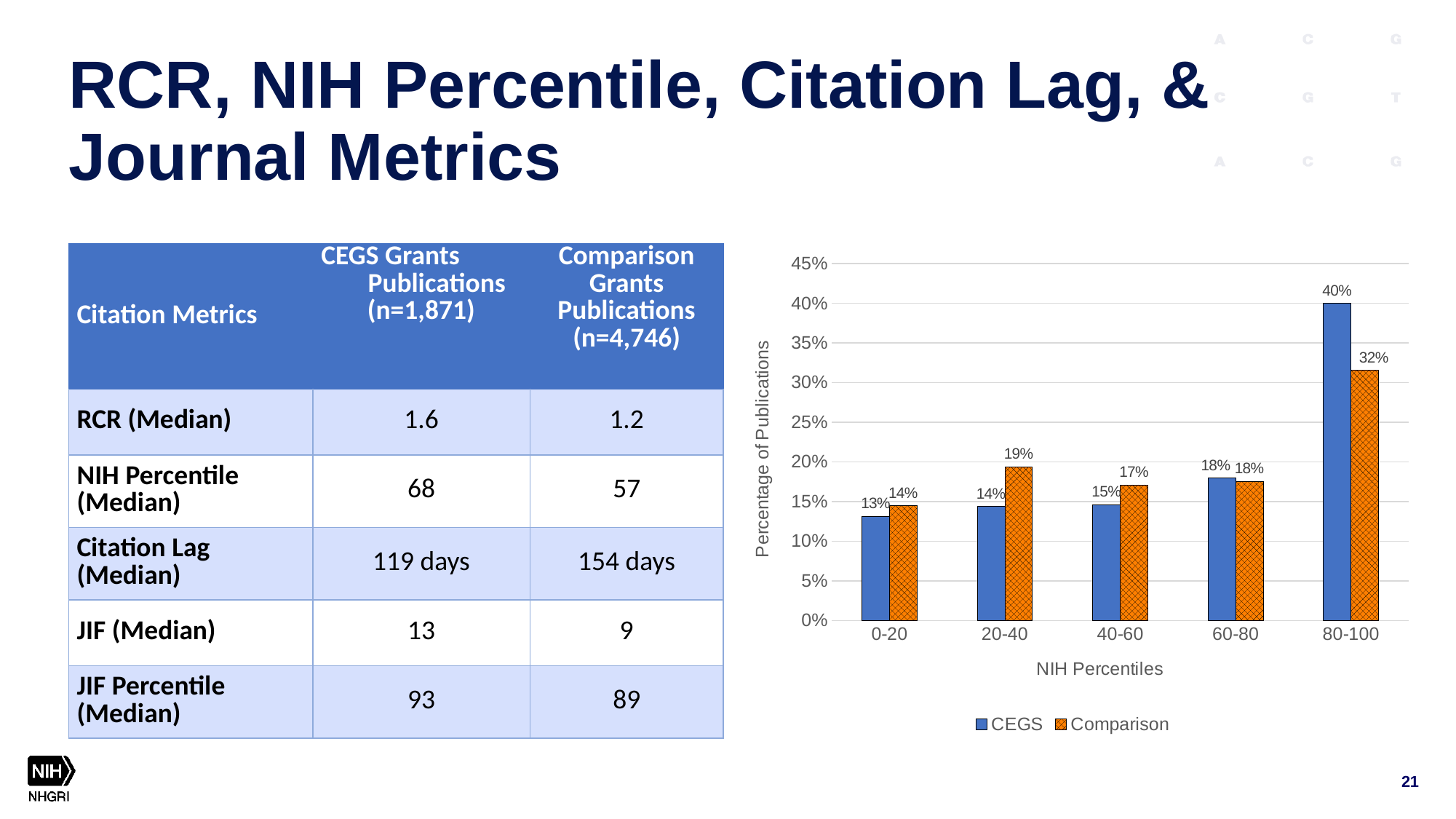
What is the CEGS value for the 80-100 NIH percentile bin? 40% How many NIH percentile bins are shown on the x axis? 5 How many series does the legend list? 2 What is the Comparison value for the 20-40 NIH percentile bin? 19% What kind of chart is shown on the slide? bar chart In the 20-40 bin, which series has the larger value, CEGS or Comparison? Comparison What is the difference between the CEGS and Comparison values in the 80-100 bin? 8% What is the label of the y axis of the chart? Percentage of Publications What is the CEGS value for the 0-20 NIH percentile bin? 13% Is the CEGS value for the 80-100 bin greater or less than 35%? greater Which NIH percentile bin has the highest CEGS value? 80-100 Which NIH percentile bin has the lowest Comparison value? 0-20